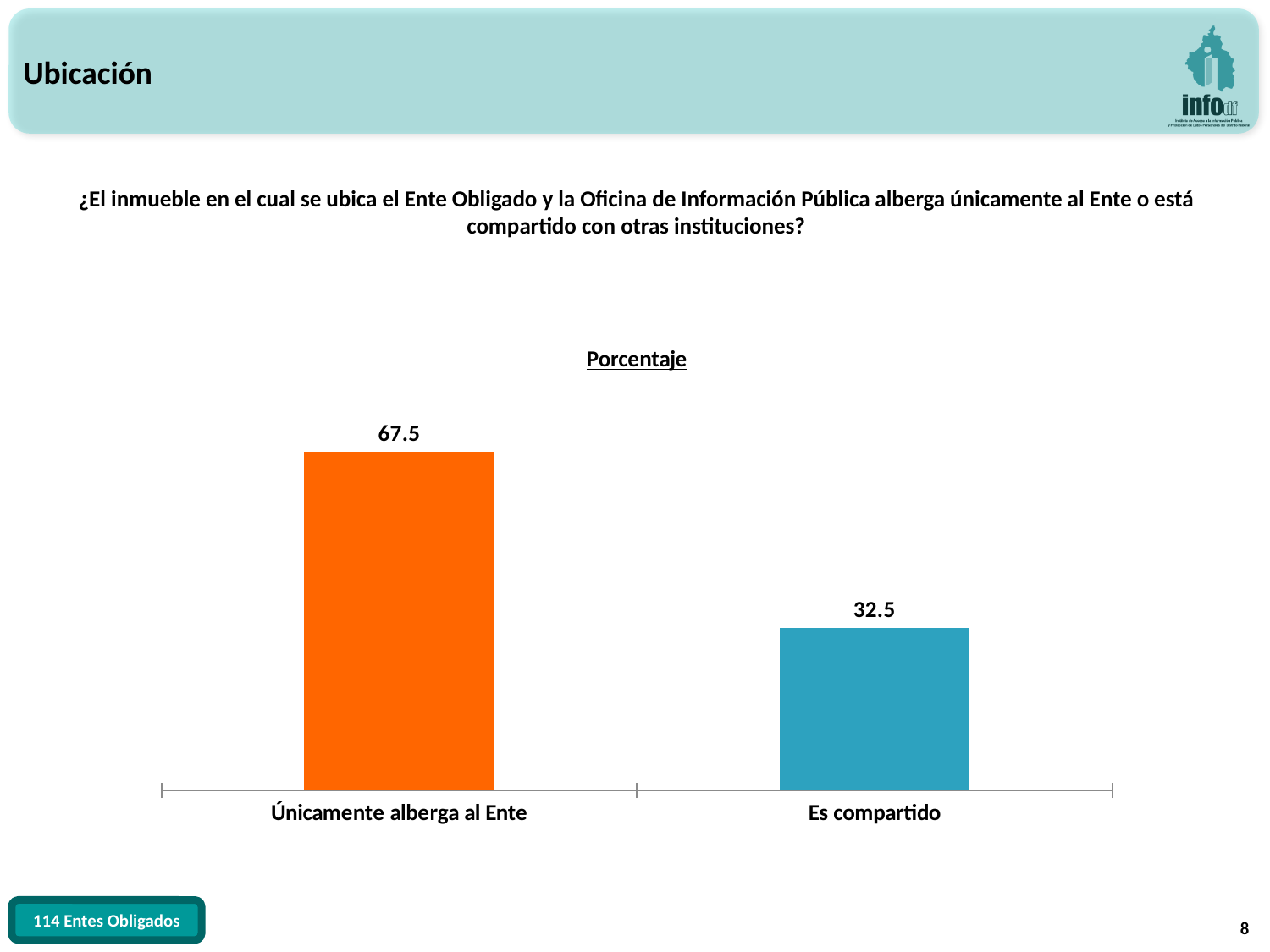
Which category has the lowest value? Es compartido Which is larger, the value for "Únicamente alberga al Ente" or for "Es compartido"? Únicamente alberga al Ente Which category has the highest value? Únicamente alberga al Ente What kind of chart is shown on the slide? Bar chart What is the title of the chart? Porcentaje How many categories are shown in the chart? 2 What is the difference between the values for "Únicamente alberga al Ente" and "Es compartido"? 35 What is the total of the two values shown in the chart? 100 What is the value for "Es compartido"? 32.5 What is the value for "Únicamente alberga al Ente"? 67.5 What colour is the bar for "Es compartido"? Blue